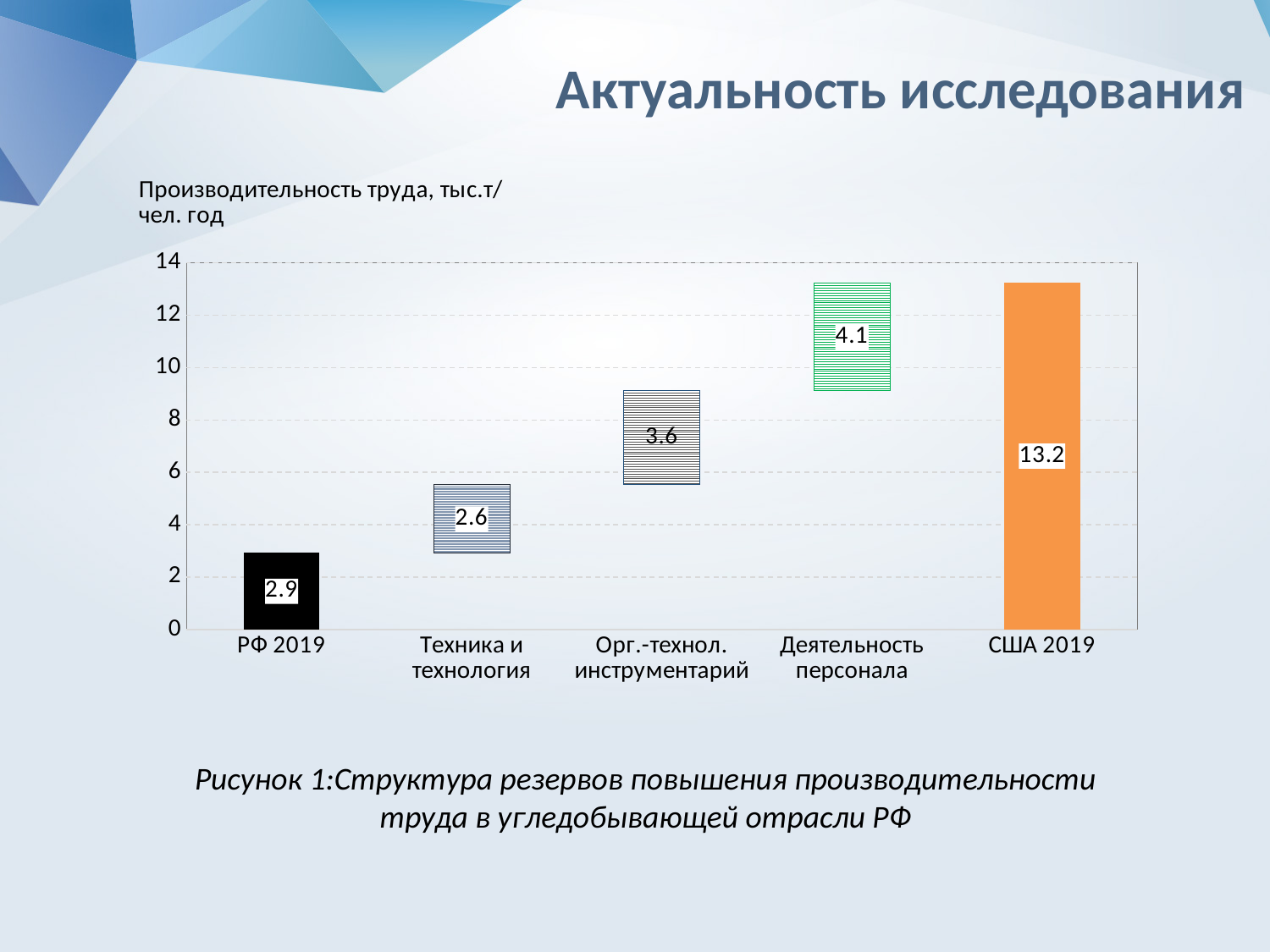
How many categories are shown on the x axis? 5 What kind of chart is shown on the slide? bar chart Which category has the highest value? США 2019 What is the value shown for РФ 2019? 2.9 What is the value shown for Техника и технология? 2.6 What is the value shown for США 2019? 13.2 What is the difference between the values for США 2019 and РФ 2019? 10.3 Which category has the lowest value? Техника и технология Which is larger, the value for Деятельность персонала or the value for Орг.-технол. инструментарий? Деятельность персонала What is the value shown for Деятельность персонала? 4.1 What is the value shown for Орг.-технол. инструментарий? 3.6 What is the label of the vertical axis? Производительность труда, тыс.т/чел. год